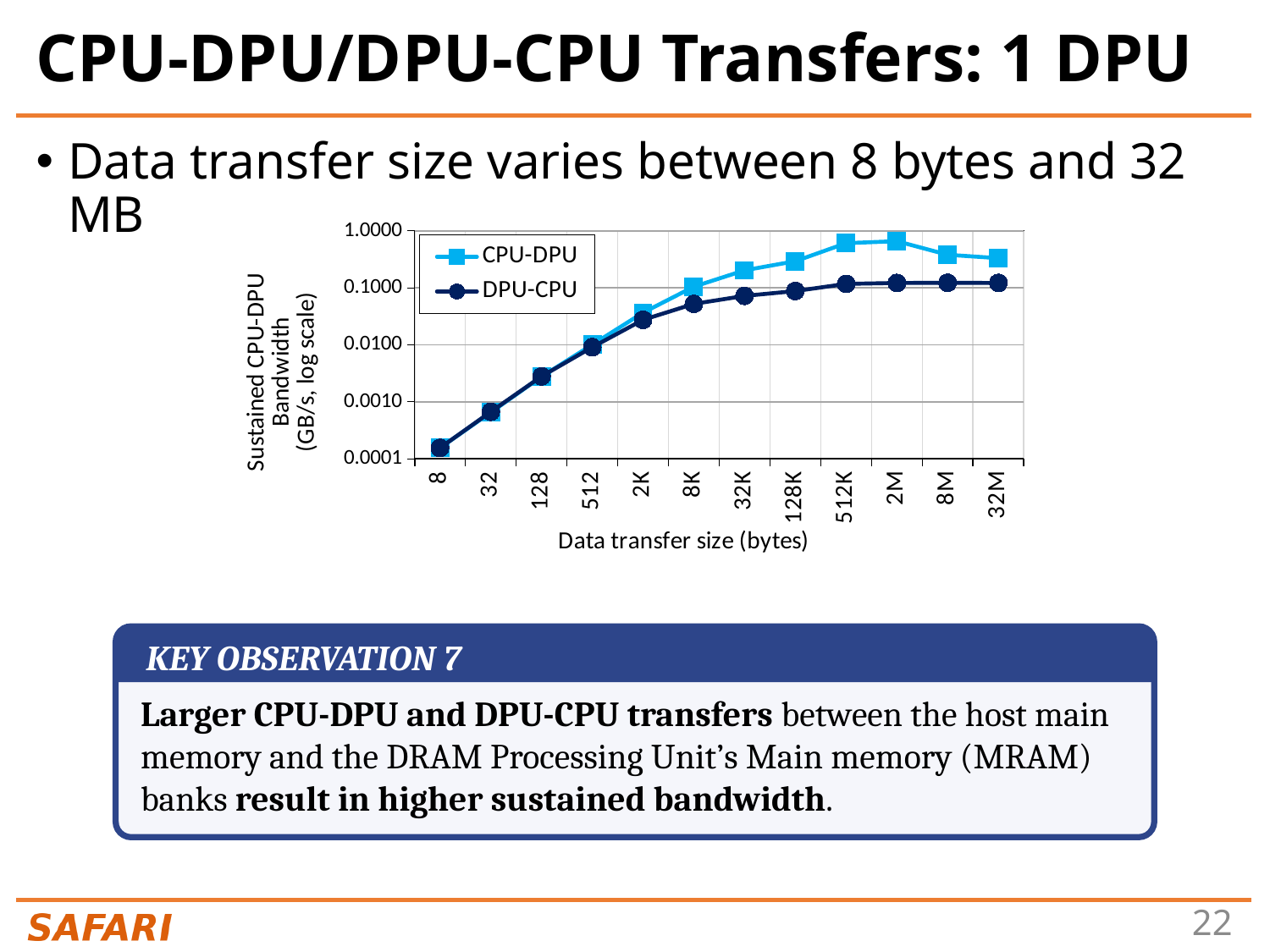
Is the CPU-DPU bandwidth at a transfer size of 32K greater or less than 0.1000? greater How many data transfer sizes are plotted along the x axis? 12 Does the DPU-CPU bandwidth generally rise or fall as the data transfer size increases from 8 bytes to 32M? rise Is the CPU-DPU bandwidth at a transfer size of 2M greater or less than 0.1000? greater At a transfer size of 2M, which series has the higher bandwidth, CPU-DPU or DPU-CPU? CPU-DPU How many series does the chart legend list? 2 Which two series are listed in the legend? CPU-DPU and DPU-CPU At which data transfer size is the CPU-DPU bandwidth lowest? 8 What is the label of the x axis? Data transfer size (bytes) What kind of chart is shown on the slide? line chart Is the DPU-CPU bandwidth at a transfer size of 8K greater or less than 0.1000? less